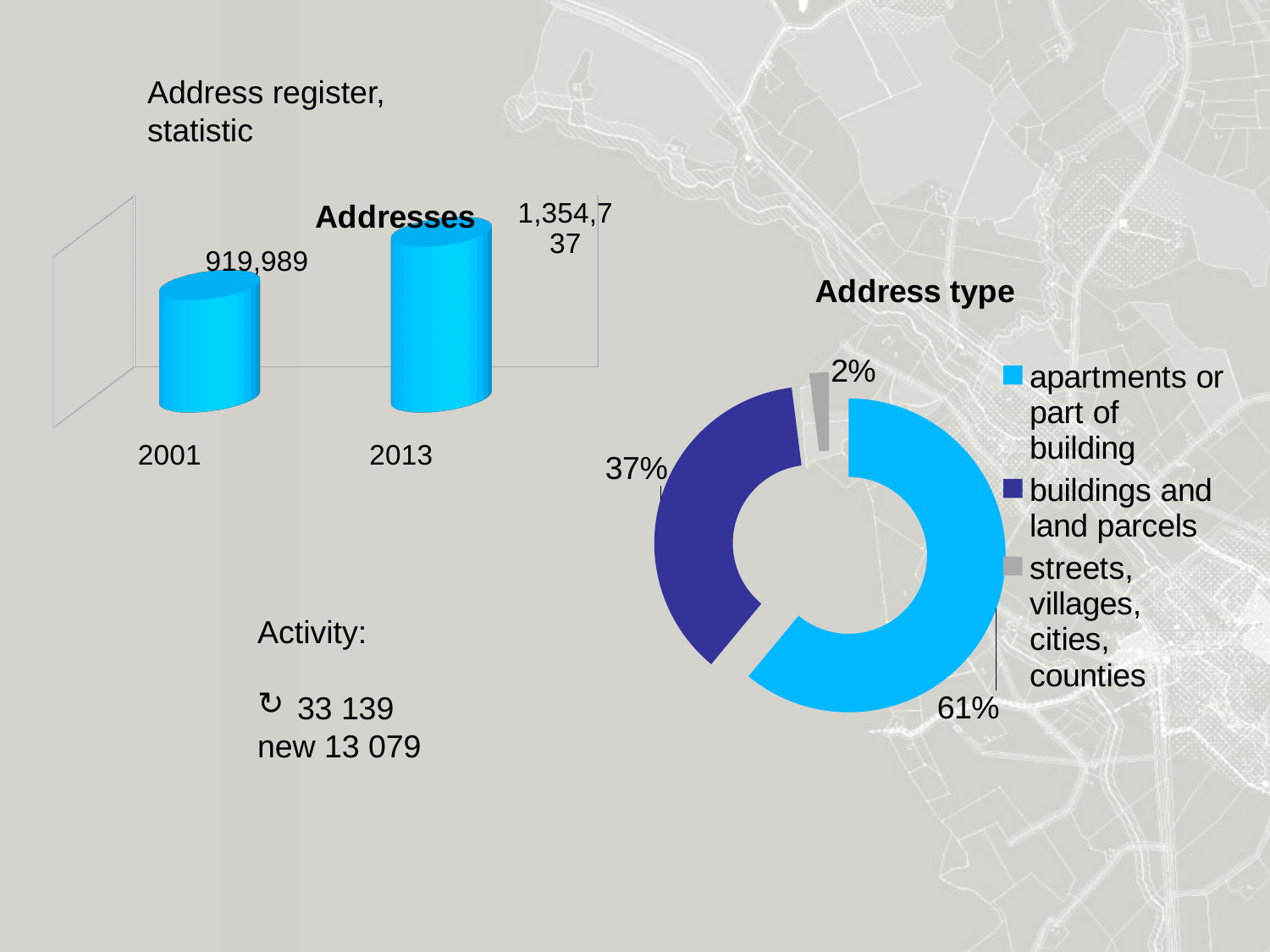
In the Addresses chart, what is the difference between the 2013 and 2001 values? 434,748 In the Address type chart, what share is apartments or part of building? 61% What kind of chart is the Addresses chart? Bar chart How many categories does the legend of the Address type chart list? 3 In the Addresses chart, how many years are shown? 2 In the Address type chart, which category has the smallest share? streets, villages, cities, counties In the Addresses chart, do the values rise or fall from 2001 to 2013? Rise In the Addresses chart, what is the value for 2001? 919,989 In the Address type chart, what share is buildings and land parcels? 37% In the Addresses chart, which year has the lower value? 2001 In the Addresses chart, what is the value for 2013? 1,354,737 In the Addresses chart, which year has the higher value? 2013